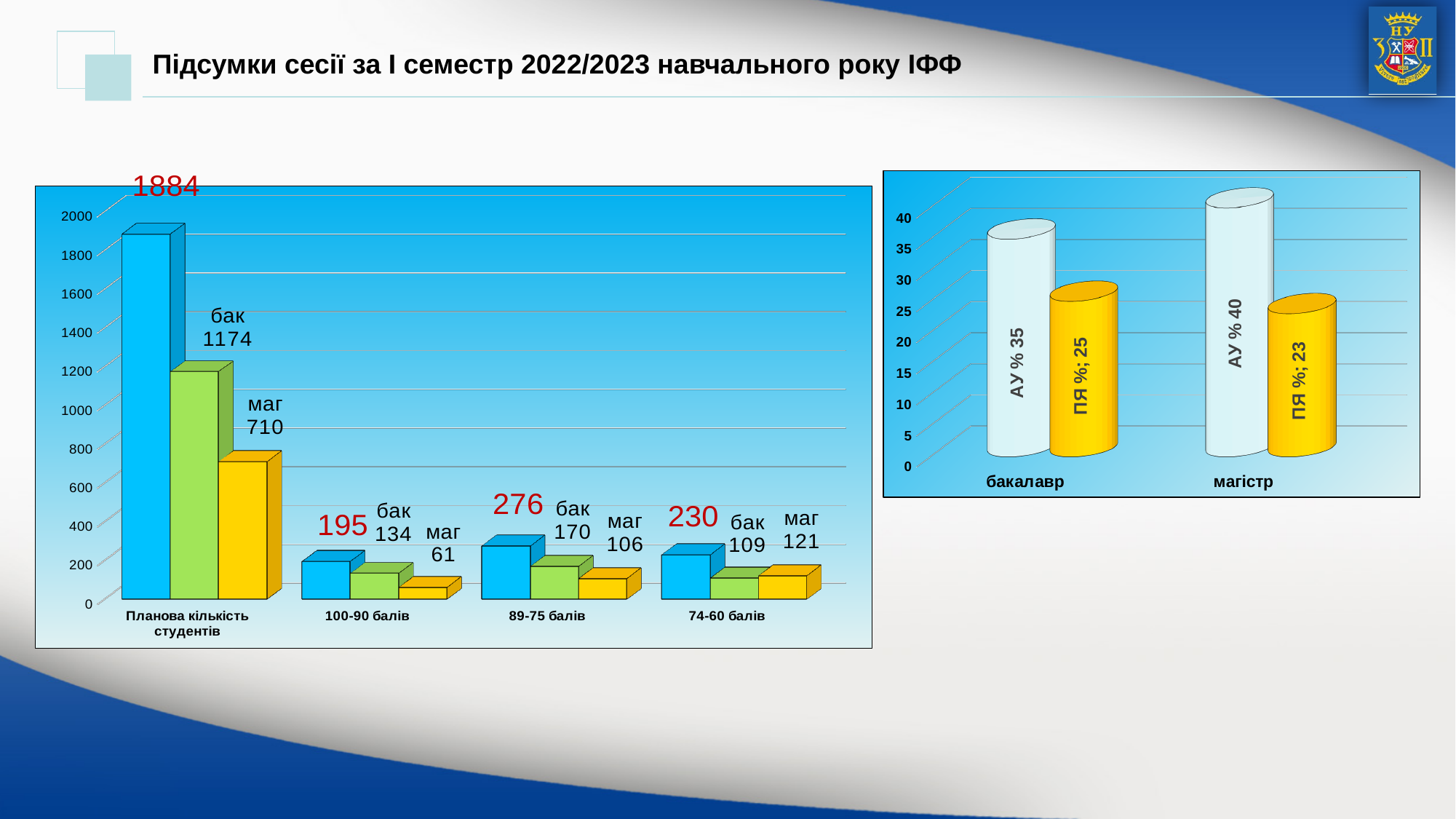
How many categories are shown on the x axis of the left chart? 4 In the left chart, which category has the lowest 'маг' value? 100-90 балів In the left chart, which category has the highest blue bar? Планова кількість студентів In the right chart, what is the difference between the 'АУ %' values for 'магістр' and 'бакалавр'? 5 What type of chart is the left chart? bar chart In the left chart, what is the 'бак' value for '74-60 балів'? 109 In the left chart, what is the value of the blue bar for 'Планова кількість студентів'? 1884 In the left chart, for '74-60 балів', which is larger: the 'бак' value or the 'маг' value? маг In the left chart, what is the difference between the 'бак' and 'маг' values for '100-90 балів'? 73 In the right chart, what is the 'ПЯ %' value for 'бакалавр'? 25 In the left chart, what is the 'маг' value for '89-75 балів'? 106 In the right chart, what is the 'АУ %' value for 'магістр'? 40